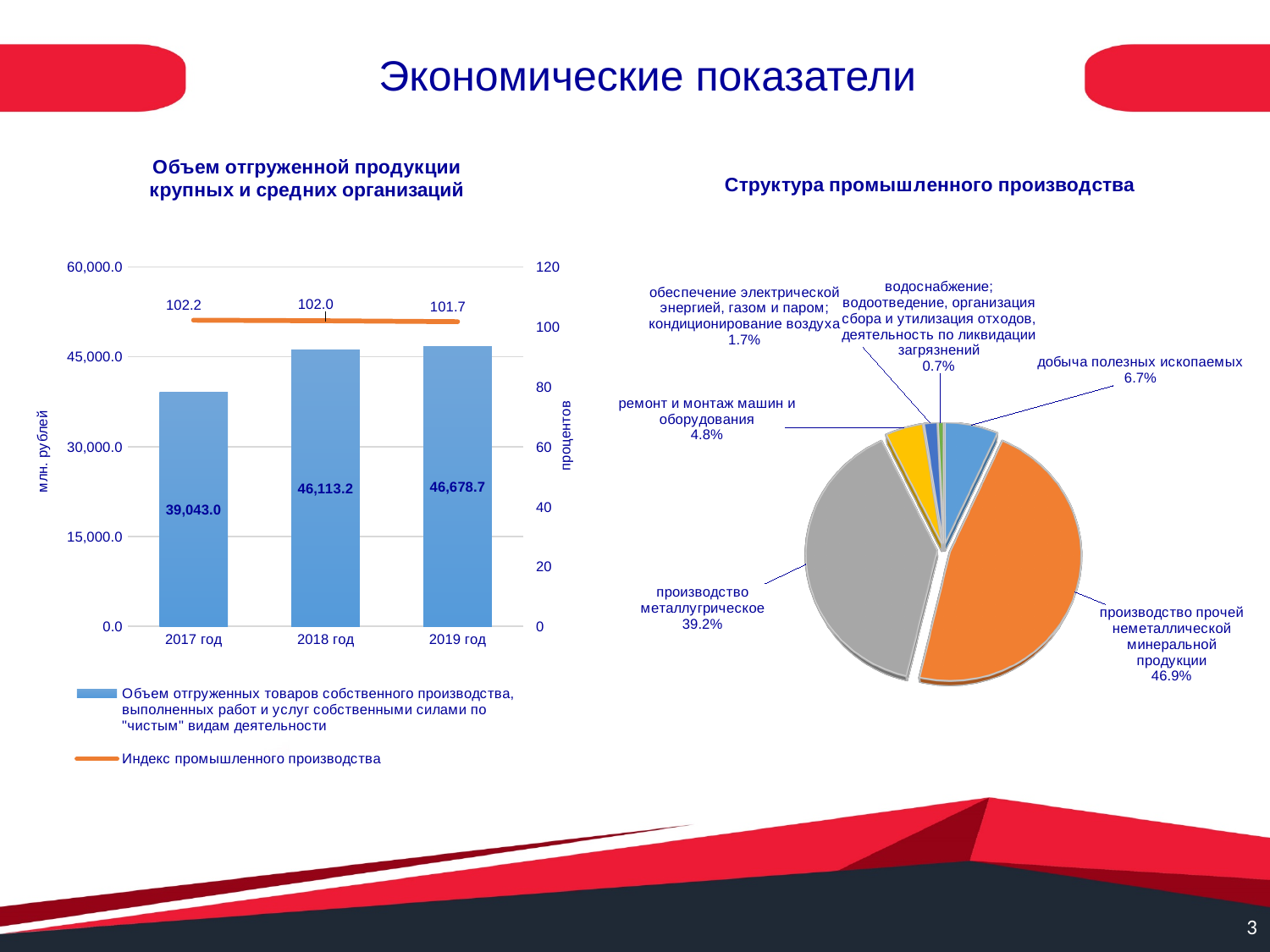
On the pie chart 'Структура промышленного производства', which category has the largest share? производство прочей неметаллической минеральной продукции On the chart 'Объем отгруженной продукции крупных и средних организаций', does the 'Индекс промышленного производства' line rise or fall from 2017 год to 2019 год? fall What kind of chart is 'Структура промышленного производства'? pie chart On the pie chart 'Структура промышленного производства', what share does 'производство металлургическое' have? 39.2% On the chart 'Объем отгруженной продукции крупных и средних организаций', what is the value of the bar for 2019 год? 46,678.7 On the chart 'Объем отгруженной продукции крупных и средних организаций', which year has the lowest bar value? 2017 год On the chart 'Объем отгруженной продукции крупных и средних организаций', what is the value of the bar for 2017 год? 39,043.0 On the chart 'Объем отгруженной продукции крупных и средних организаций', how many years are shown on the x axis? 3 On the chart 'Объем отгруженной продукции крупных и средних организаций', how many series does the legend list? 2 On the chart 'Объем отгруженной продукции крупных и средних организаций', what is the value of 'Индекс промышленного производства' for 2018 год? 102.0 On the pie chart 'Структура промышленного производства', which is larger: 'добыча полезных ископаемых' or 'ремонт и монтаж машин и оборудования'? добыча полезных ископаемых On the chart 'Объем отгруженной продукции крупных и средних организаций', what is the difference between the bar values for 2018 год and 2017 год? 7,070.2